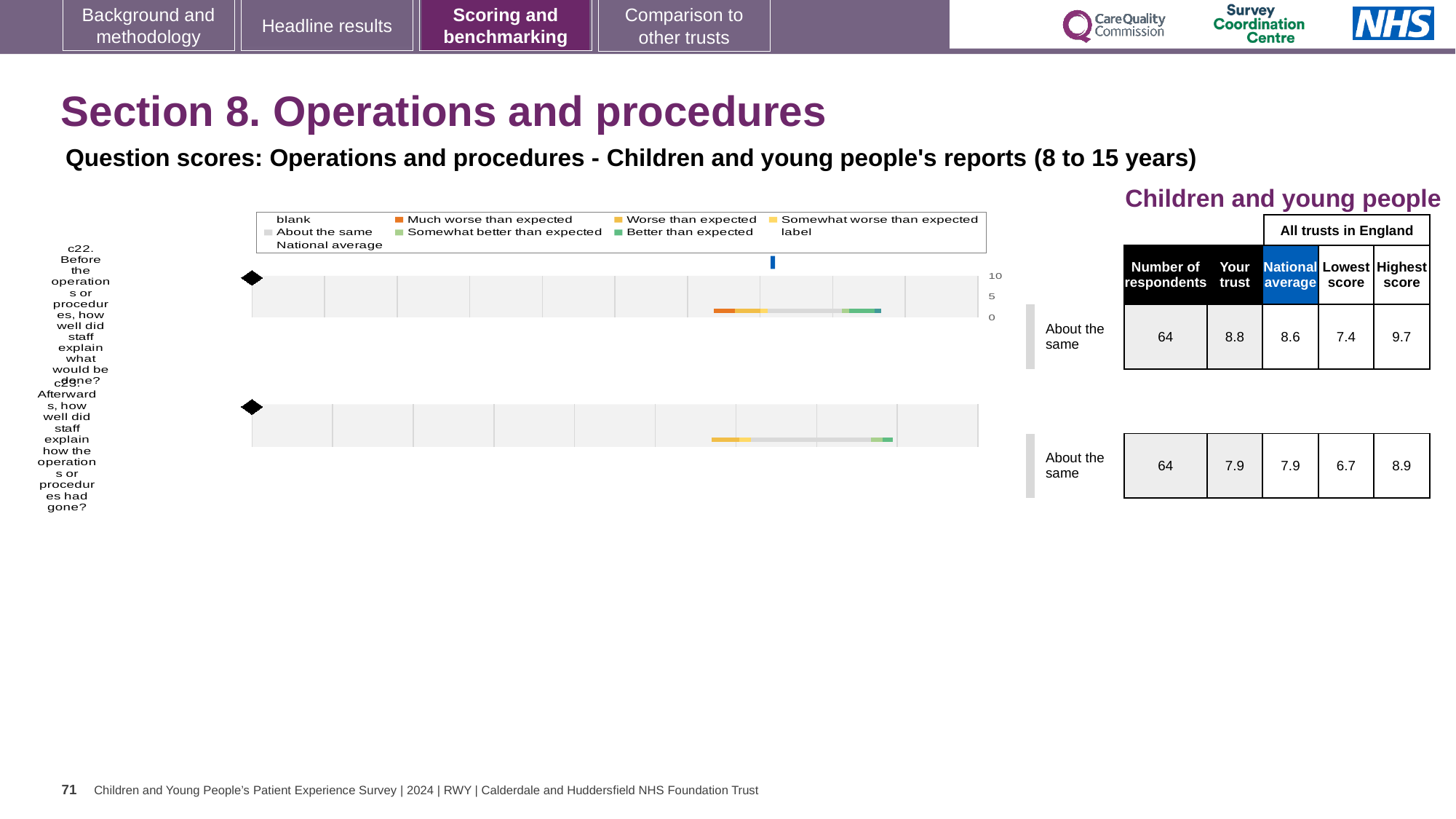
For question c22, which is larger: the 'Your trust' score or the national average? Your trust What is the highest value shown on the chart's axis? 10 Which legend entry is shown in orange? Much worse than expected What benchmark category is given for question c23? About the same What is the 'Your trust' score for question c22 (Before the operations or procedures, how well did staff explain what would be done?)? 8.8 How many respondents answered question c22? 64 What is the lowest score across all trusts in England for question c23? 6.7 What is the difference between the highest and lowest scores for question c22? 2.3 What is the highest score across all trusts in England for question c22? 9.7 What is the national average score for question c23 (Afterwards, how well did staff explain how the operations or procedures had gone?)? 7.9 How many questions (rows) are plotted in the chart area? 2 What kind of chart is used to show the question scores for c22 and c23? bar chart